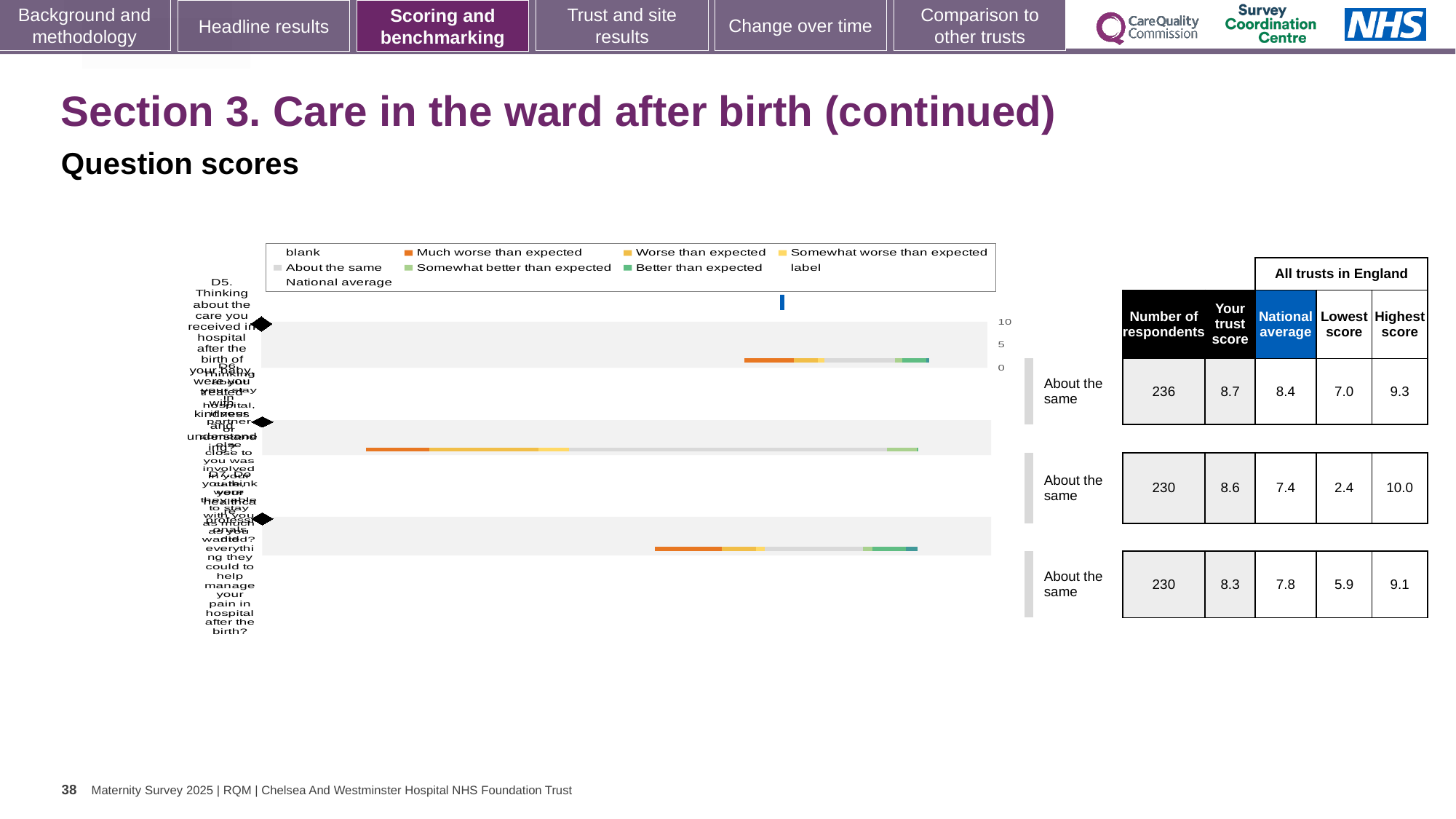
In the table beside the chart, what is the national average for the first row? 8.4 In the table beside the chart, is the trust score or the national average larger for the third row? trust score (8.3) In the table beside the chart, what is 'Your trust score' for the first row? 8.7 In the chart legend, what colour represents 'Much worse than expected'? orange How many question rows (bars) does the chart show? 3 In the table beside the chart, which row has the lowest 'Lowest score' value? second row (2.4) What kind of chart is shown on the slide? bar chart In the chart legend, what colour represents 'Better than expected'? green In the table beside the chart, what is the difference between the trust score and the national average for the second row? 1.2 In the table beside the chart, what is the lowest score for the third row? 5.9 In the table beside the chart, what is the number of respondents for the first row? 236 In the table beside the chart, what is the highest score for the second row? 10.0